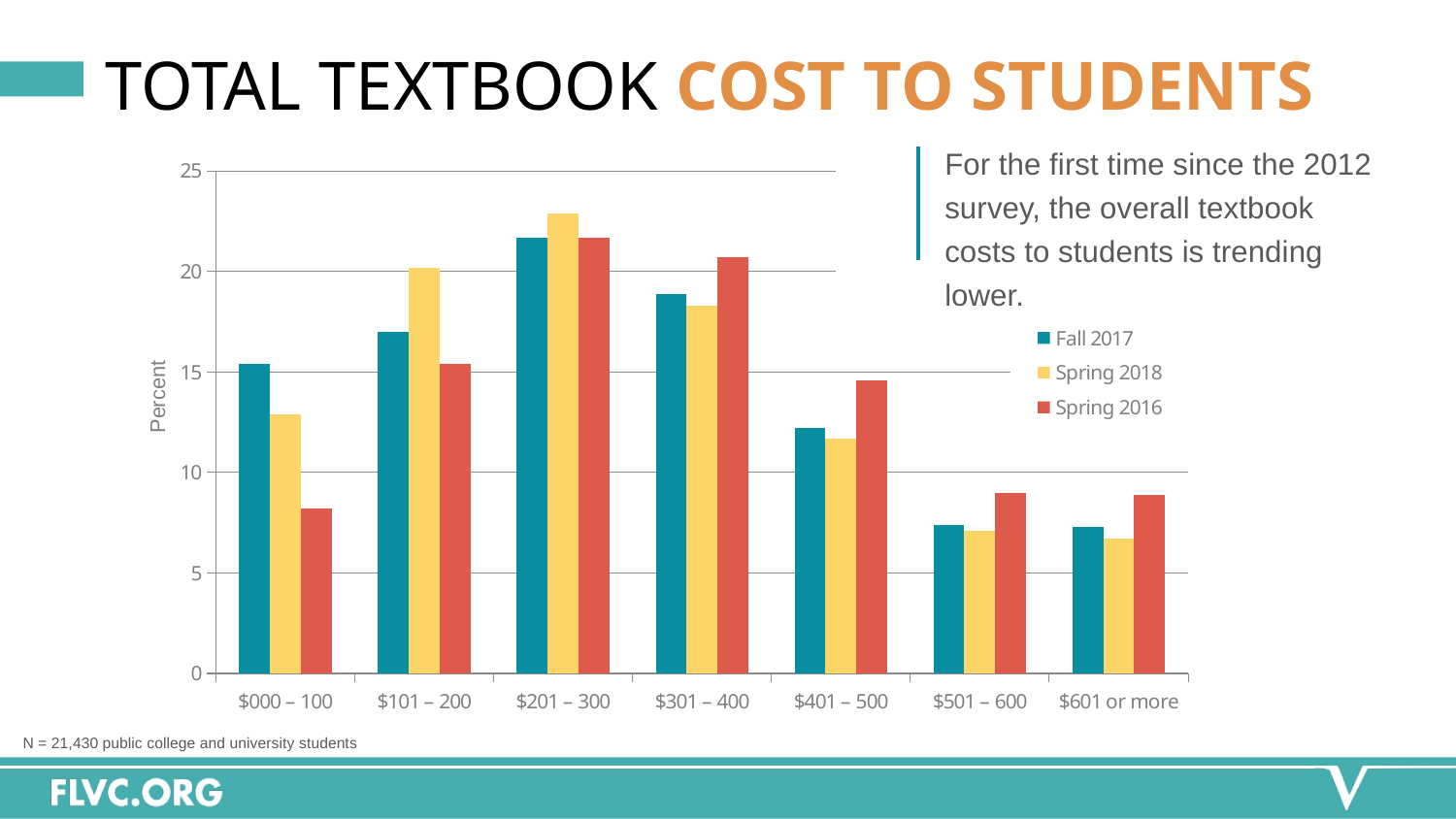
Which cost category has the highest value for Spring 2018? $201 – 300 Which cost category has the lowest value for Spring 2016? $000 – 100 For the $000 – 100 category, which is larger: Fall 2017 or Spring 2016? Fall 2017 For the $301 – 400 category, which is larger: Spring 2016 or Spring 2018? Spring 2016 How many cost categories are shown on the x axis? 7 How many series does the legend list? 3 Is the Spring 2016 value for $000 – 100 greater or less than 10? less Is the Spring 2018 value for $401 – 500 greater or less than 15? less Which series is shown in red in the legend? Spring 2016 What kind of chart is shown on the slide? bar chart What is the label on the y axis? Percent Is the Fall 2017 value for $201 – 300 greater or less than 20? greater